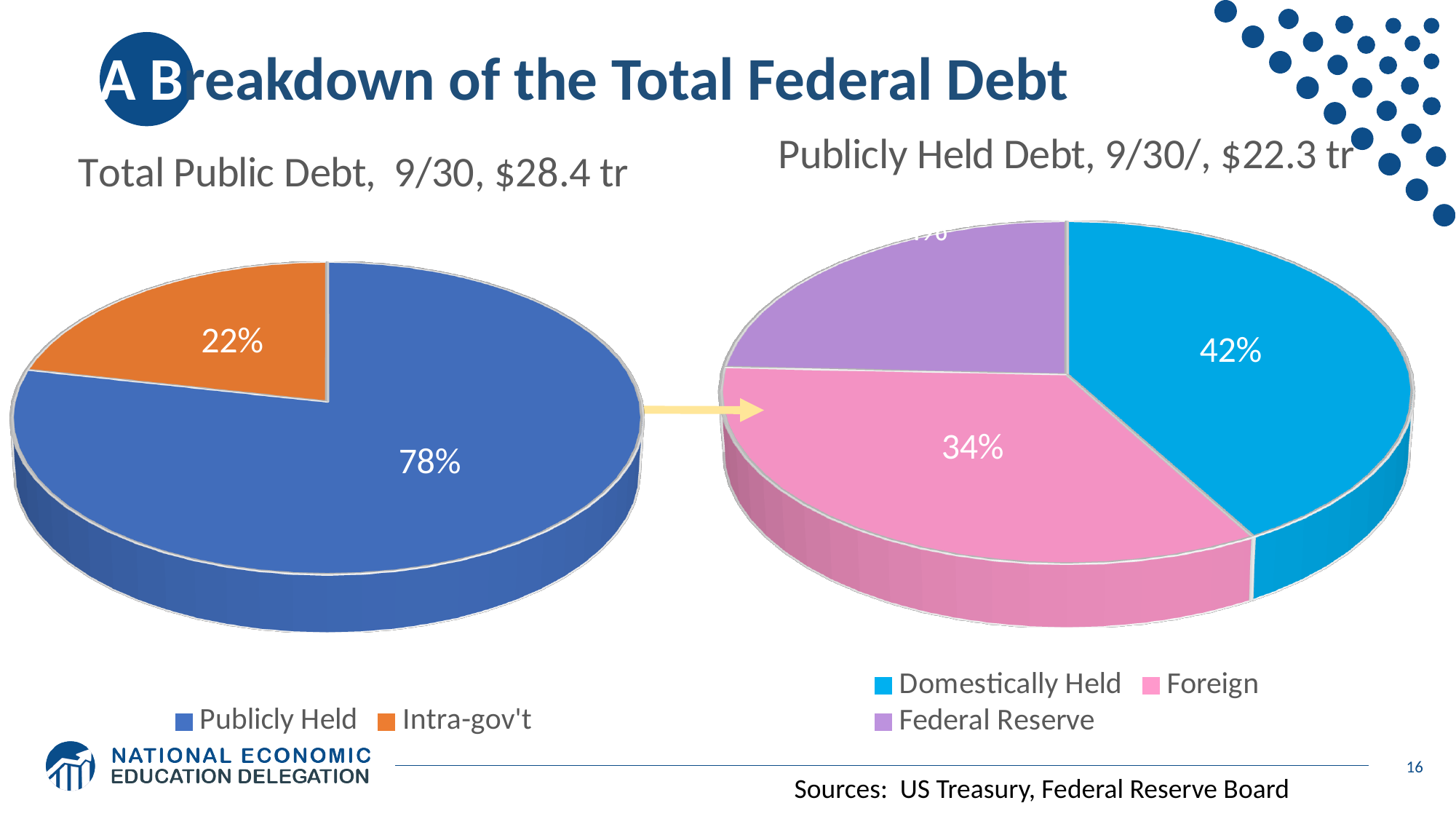
In the 'Total Public Debt, 9/30, $28.4 tr' chart, how many percentage points larger is Publicly Held than Intra-gov't? 56 What kind of chart is the 'Total Public Debt, 9/30, $28.4 tr' chart? Pie chart In the 'Publicly Held Debt, 9/30/, $22.3 tr' chart, what share is Foreign? 34% How many entries does the legend of the 'Publicly Held Debt, 9/30/, $22.3 tr' chart list? 3 In the 'Publicly Held Debt, 9/30/, $22.3 tr' chart, what colour is the Foreign slice? Pink In the 'Publicly Held Debt, 9/30/, $22.3 tr' chart, what share is Domestically Held? 42% In the 'Publicly Held Debt, 9/30/, $22.3 tr' chart, which is larger: Domestically Held or Federal Reserve? Domestically Held In the 'Total Public Debt, 9/30, $28.4 tr' chart, what share is Intra-gov't? 22% In the 'Publicly Held Debt, 9/30/, $22.3 tr' chart, which slice is the largest? Domestically Held In the 'Total Public Debt, 9/30, $28.4 tr' chart, what share is Publicly Held? 78% In the 'Total Public Debt, 9/30, $28.4 tr' chart, which slice is the largest? Publicly Held How many slices does the 'Total Public Debt, 9/30, $28.4 tr' pie chart have? 2